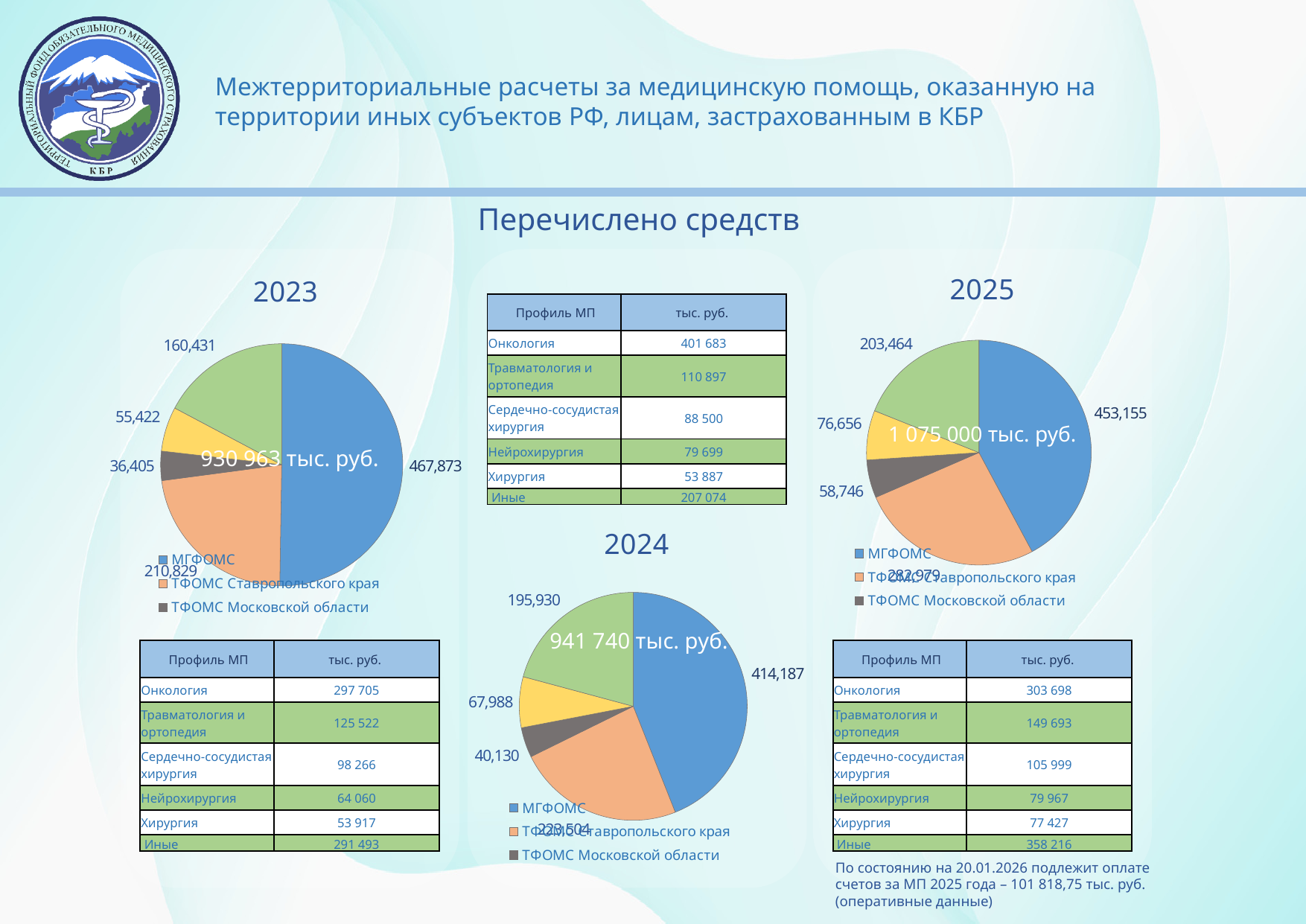
On the 2023 pie chart, what is the difference between the МГФОМС value and the ТФОМС Московской области value? 431,468 On the 2023 pie chart, which legend category has the largest slice? МГФОМС On the 2025 pie chart, what total is printed in the centre of the pie? 1 075 000 тыс. руб. Which is larger: the ТФОМС Московской области value on the 2023 chart or on the 2025 chart? 2025 On the 2024 pie chart, what value is shown for ТФОМС Московской области? 40,130 How many slices does the 2024 pie chart have? 5 On the 2023 pie chart, what value is shown for МГФОМС? 467,873 What kind of chart is used for the 2023, 2024 and 2025 data? Pie chart On the 2024 pie chart, which legend category has the smallest slice? ТФОМС Московской области On the 2025 pie chart, what is the difference between the МГФОМС value and the ТФОМС Московской области value? 394,409 On the 2025 pie chart, what value is shown for МГФОМС? 453,155 On the 2024 pie chart, what is the difference between the МГФОМС value (414,187) and the green slice value (195,930)? 218,257